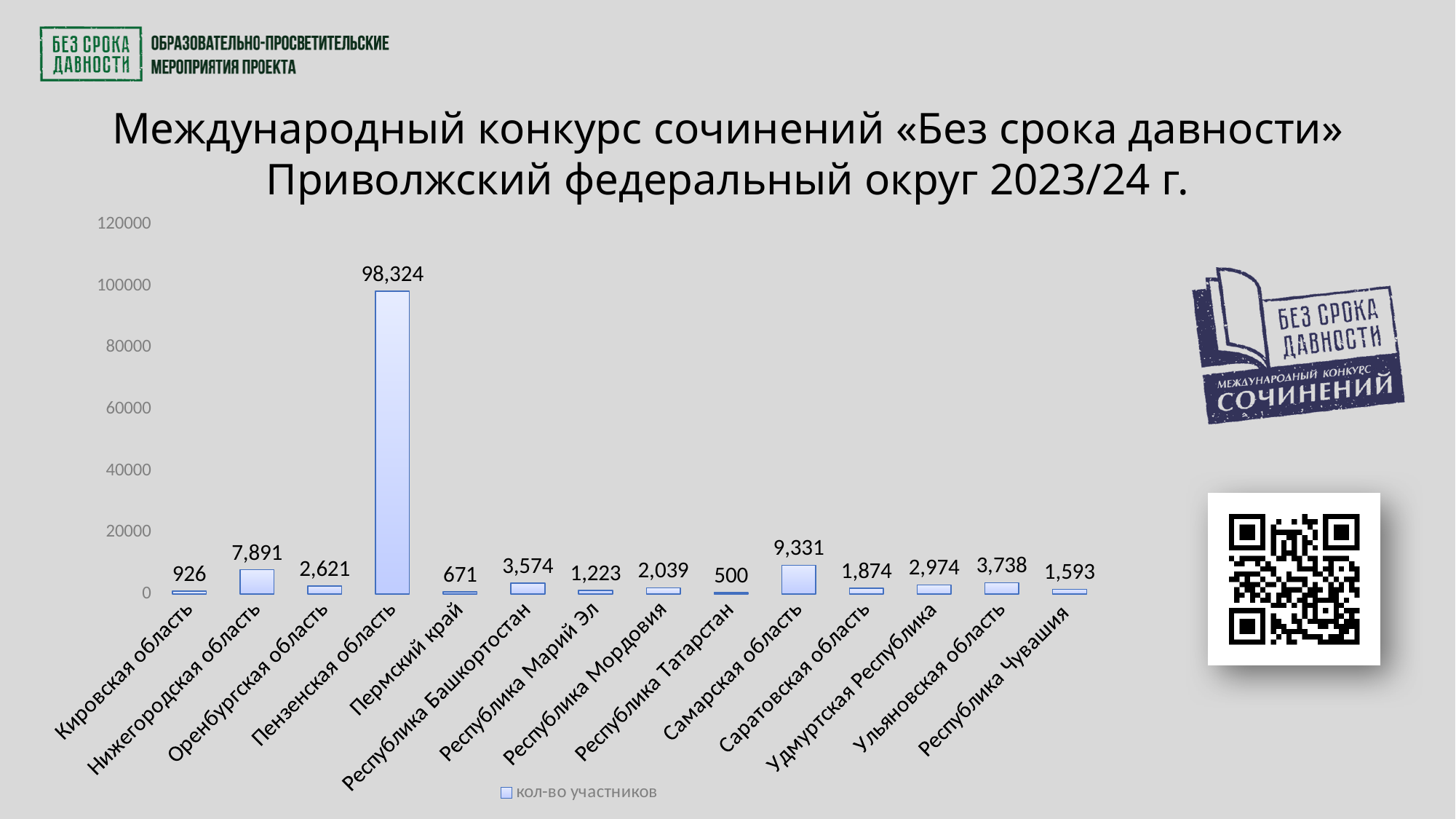
Which region has the lowest value? Республика Татарстан Which is larger, the value for Ульяновская область or Удмуртская Республика? Ульяновская область What is the value for Самарская область? 9,331 How many regions are shown on the chart? 14 How many series does the legend list? 1 Is the value for Пензенская область greater or less than 80000? greater What is the value for Пензенская область? 98,324 Which region has the highest value? Пензенская область What is the value for Республика Башкортостан? 3,574 What is the difference between the values for Самарская область and Нижегородская область? 1,440 What is the legend entry of the chart? кол-во участников What kind of chart is shown on the slide? bar chart